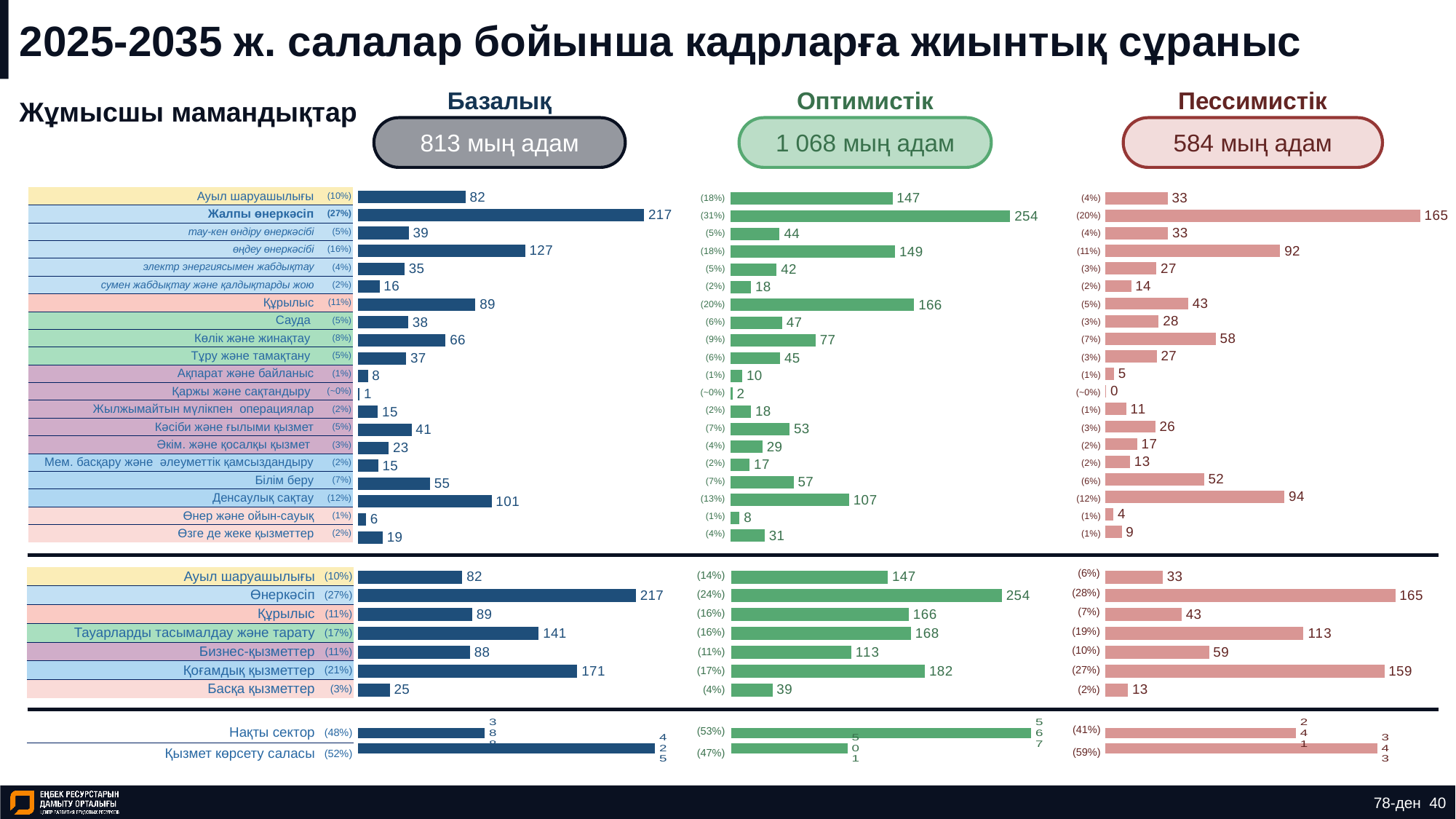
What total is shown in the rounded box for the Оптимистік scenario? 1 068 мың адам What kind of chart is used to show the values on this slide? bar chart In the Базалық chart, which category in the top section has the highest value? Жалпы өнеркәсіп In the Оптимистік chart, what is the value for Құрылыс in the top section? 166 In the Пессимистік chart, which is larger: Құрылыс or Көлік және жинақтау? Көлік және жинақтау In the Пессимистік chart, what is the value for Денсаулық сақтау? 94 In the Базалық chart, what is the value for Жалпы өнеркәсіп? 217 How many categories are listed in the middle section of the Базалық chart? 7 In the Оптимистік chart, which category in the top section has the lowest value? Қаржы және сақтандыру In the Базалық chart, what is the value for Білім беру? 55 In the middle section of the Оптимистік chart, what is the value for Қоғамдық қызметтер? 182 What is the difference between the Оптимистік and Базалық values for Ауыл шаруашылығы? 65